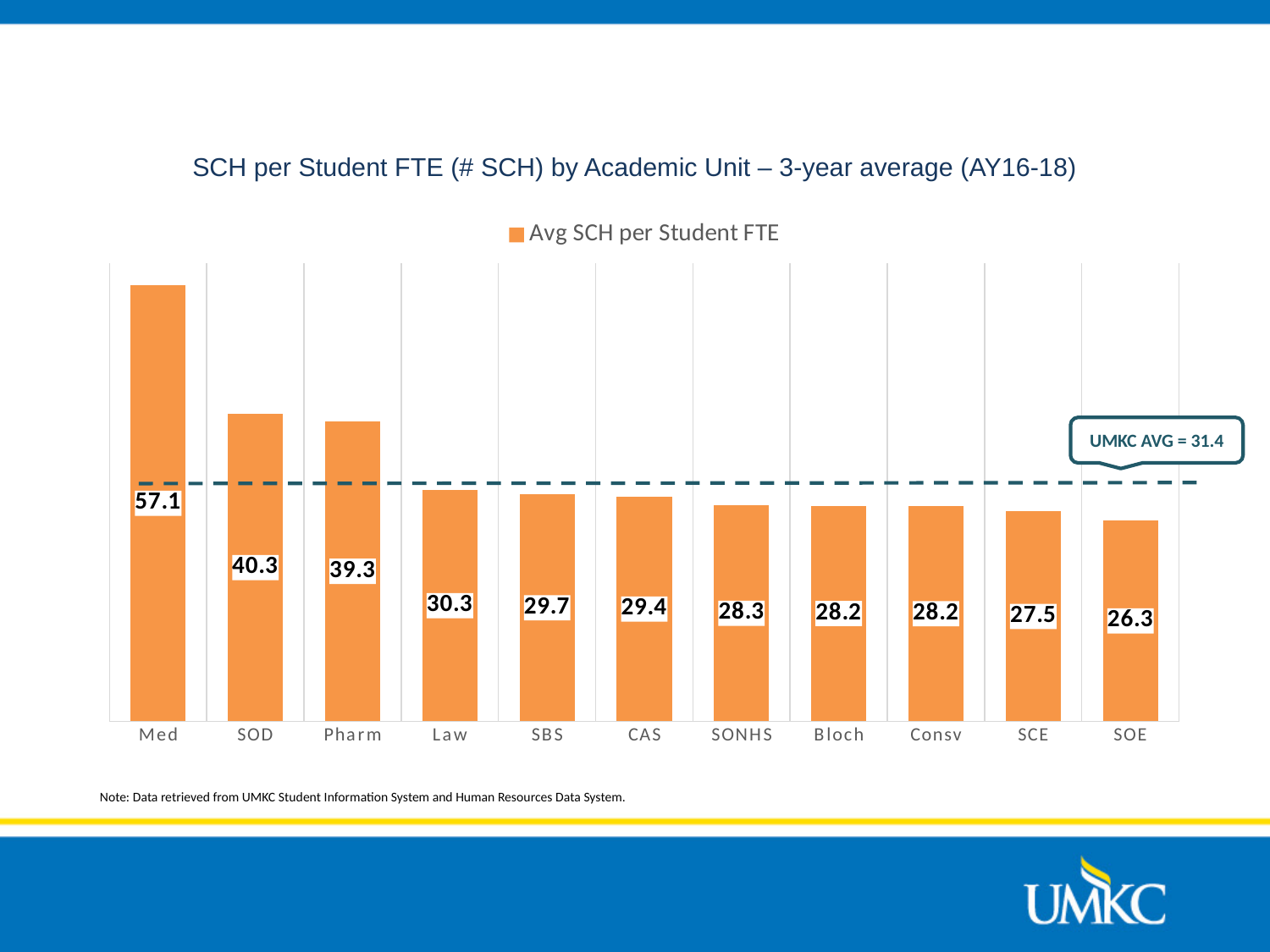
What is the UMKC average value shown by the dashed line on the chart? 31.4 What is the difference between the Avg SCH per Student FTE for Med and SOD? 16.8 Which academic unit has the lowest Avg SCH per Student FTE? SOE What is the difference between the Avg SCH per Student FTE for SOD and Pharm? 1.0 Which has a higher Avg SCH per Student FTE, Law or CAS? Law What is the Avg SCH per Student FTE for Law? 30.3 What kind of chart is shown on the slide? Bar chart Which academic unit has the highest Avg SCH per Student FTE? Med What is the Avg SCH per Student FTE for Med? 57.1 What is the Avg SCH per Student FTE for SCE? 27.5 How many academic units are shown on the chart? 11 How many series does the legend list? 1